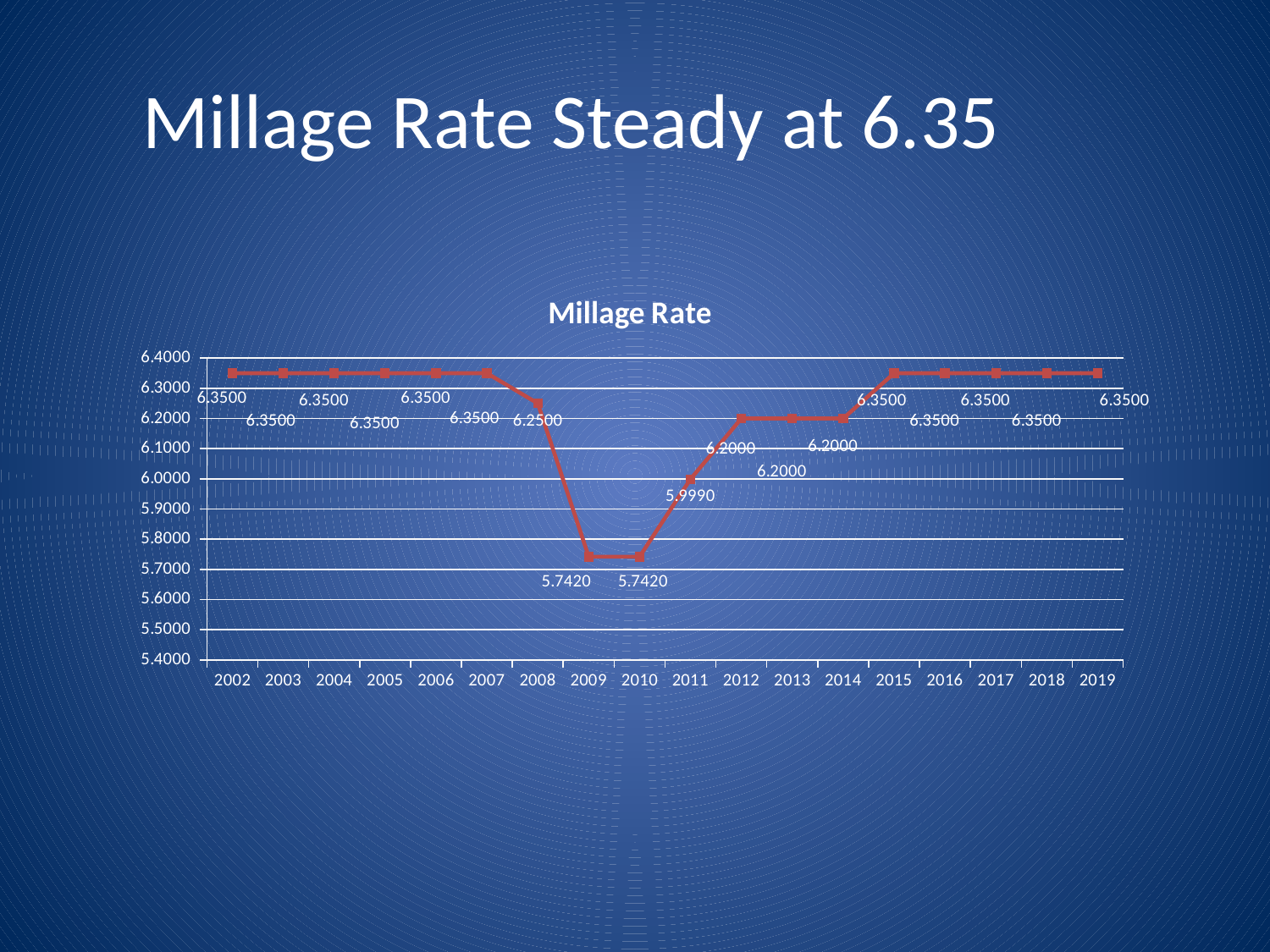
What is the difference between the millage rate in 2008 and in 2009? 0.5080 What is the lowest millage rate shown on the chart? 5.7420 Which year has the higher millage rate, 2011 or 2014? 2014 How many years are plotted on the x axis? 18 Is the millage rate for 2011 greater or less than 6.0000? less What is the difference between the millage rate in 2012 and in 2011? 0.2010 What is the millage rate for 2011? 5.9990 What is the millage rate for 2019? 6.3500 What is the millage rate for 2008? 6.2500 Does the millage rate rise or fall from 2010 to 2015? rise What kind of chart is shown on the slide? line chart What is the millage rate for 2013? 6.2000